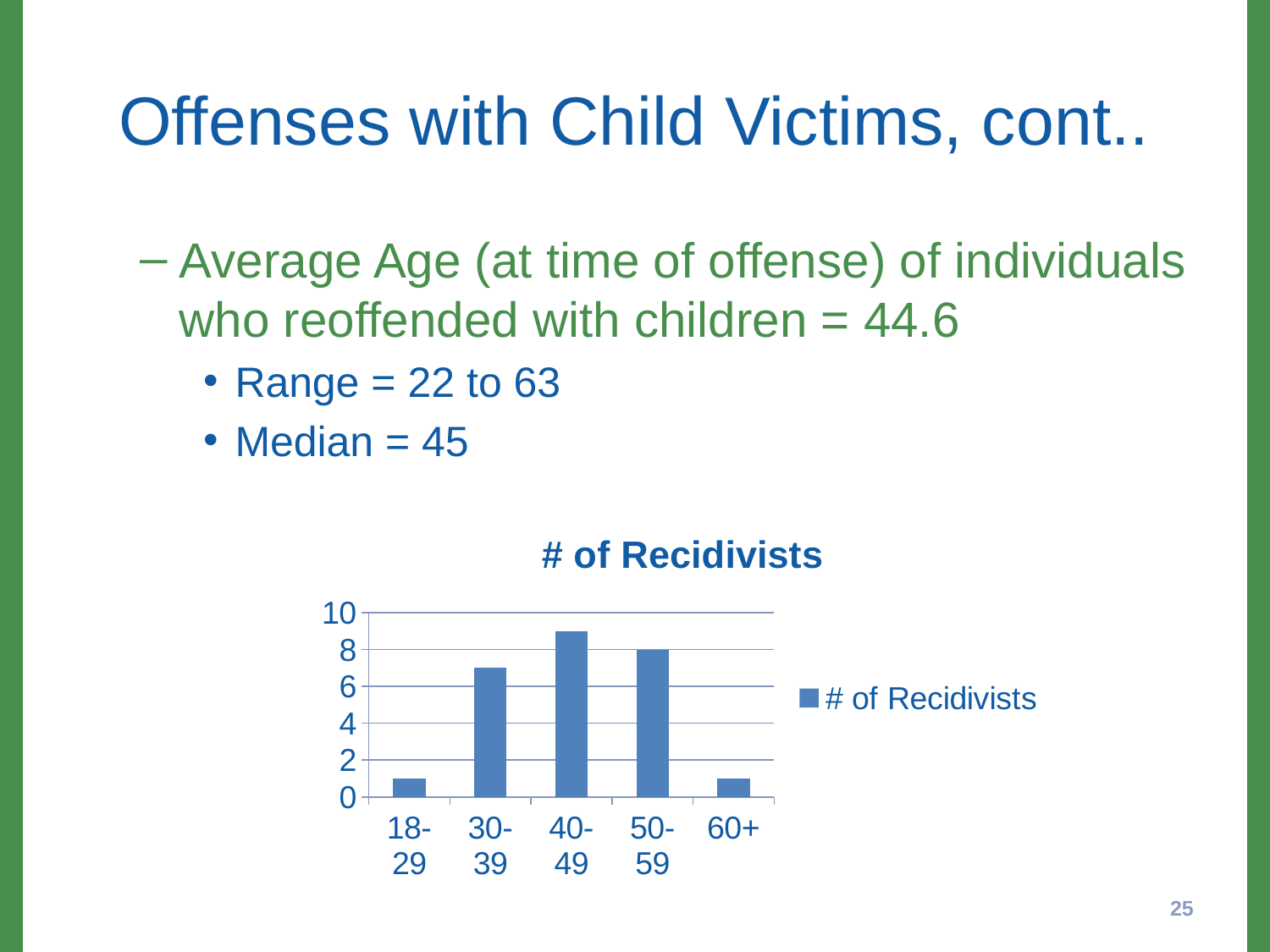
What is the title of the chart? # of Recidivists Is the value for the 18-29 age group greater or less than 2? less Is the value for the 30-39 age group greater or less than 6? greater Which age group has the highest number of recidivists? 40-49 Is the value for the 40-49 age group greater or less than 8? greater Which has more recidivists, the 30-39 age group or the 50-59 age group? 50-59 What type of chart is shown on the slide? bar chart How many series does the chart's legend list? 1 How many age categories are shown on the x axis of the chart? 5 Do the values rise or fall from the 18-29 age group to the 40-49 age group? rise Which has more recidivists, the 18-29 age group or the 30-39 age group? 30-39